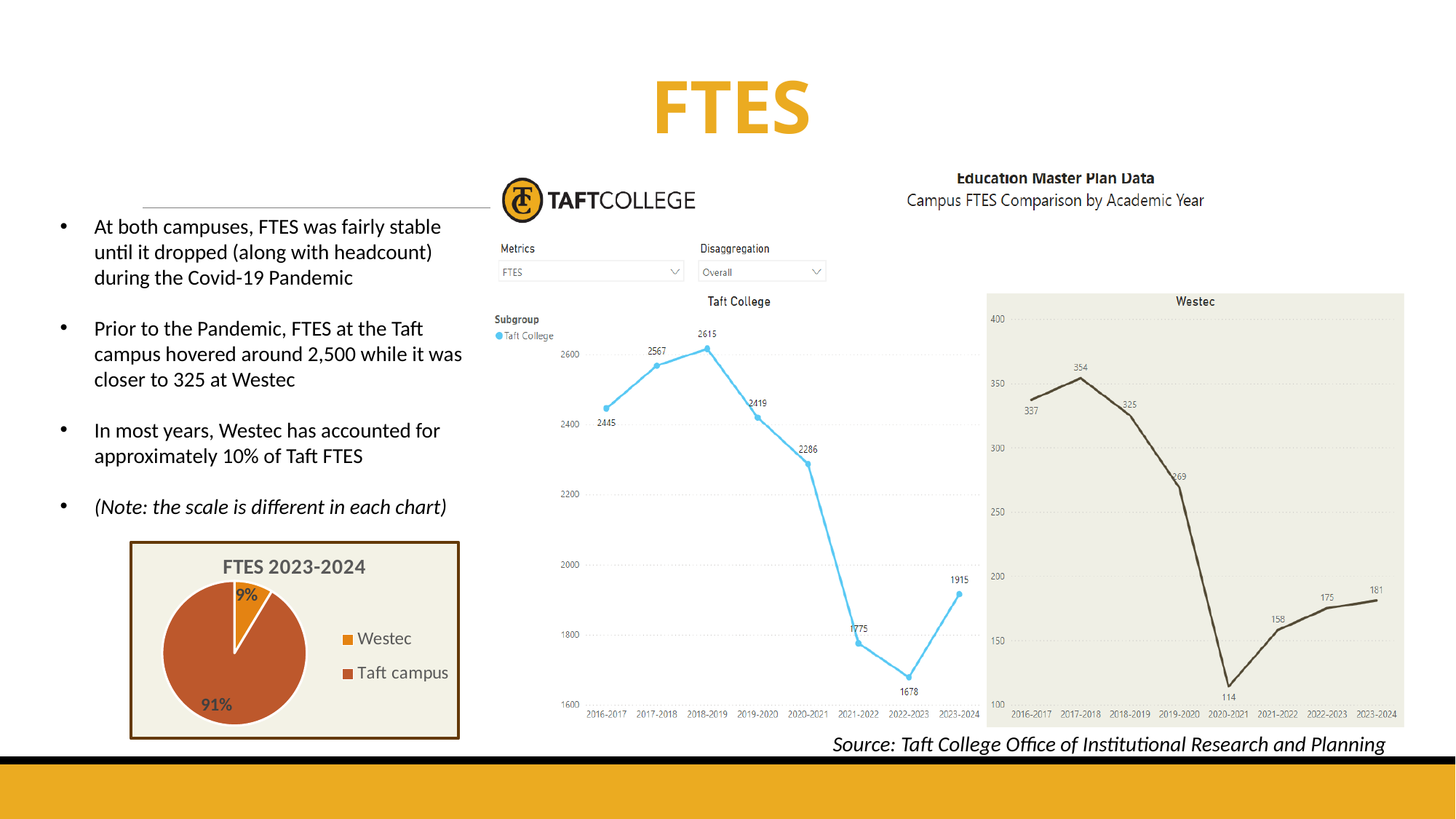
In the FTES 2023-2024 pie chart, how many categories does the legend list? 2 In the Westec line chart, what is the FTES value for 2020-2021? 114 In the Taft College line chart, what is the difference between the FTES values for 2017-2018 and 2022-2023? 889 In the Taft College line chart, what is the FTES value for 2018-2019? 2615 In the Westec line chart, is the value for 2023-2024 larger or smaller than the value for 2019-2020? smaller In the Westec line chart, do the values rise or fall from 2020-2021 to 2023-2024? rise In the Westec line chart, what is the difference between the FTES values for 2016-2017 and 2023-2024? 156 What type of chart is the FTES 2023-2024 chart? pie chart In the Westec line chart, which academic year has the highest FTES value? 2017-2018 In the Taft College line chart, which academic year has the lowest FTES value? 2022-2023 In the FTES 2023-2024 pie chart, what share does Westec account for? 9% In the Taft College line chart, how many academic years are plotted? 8